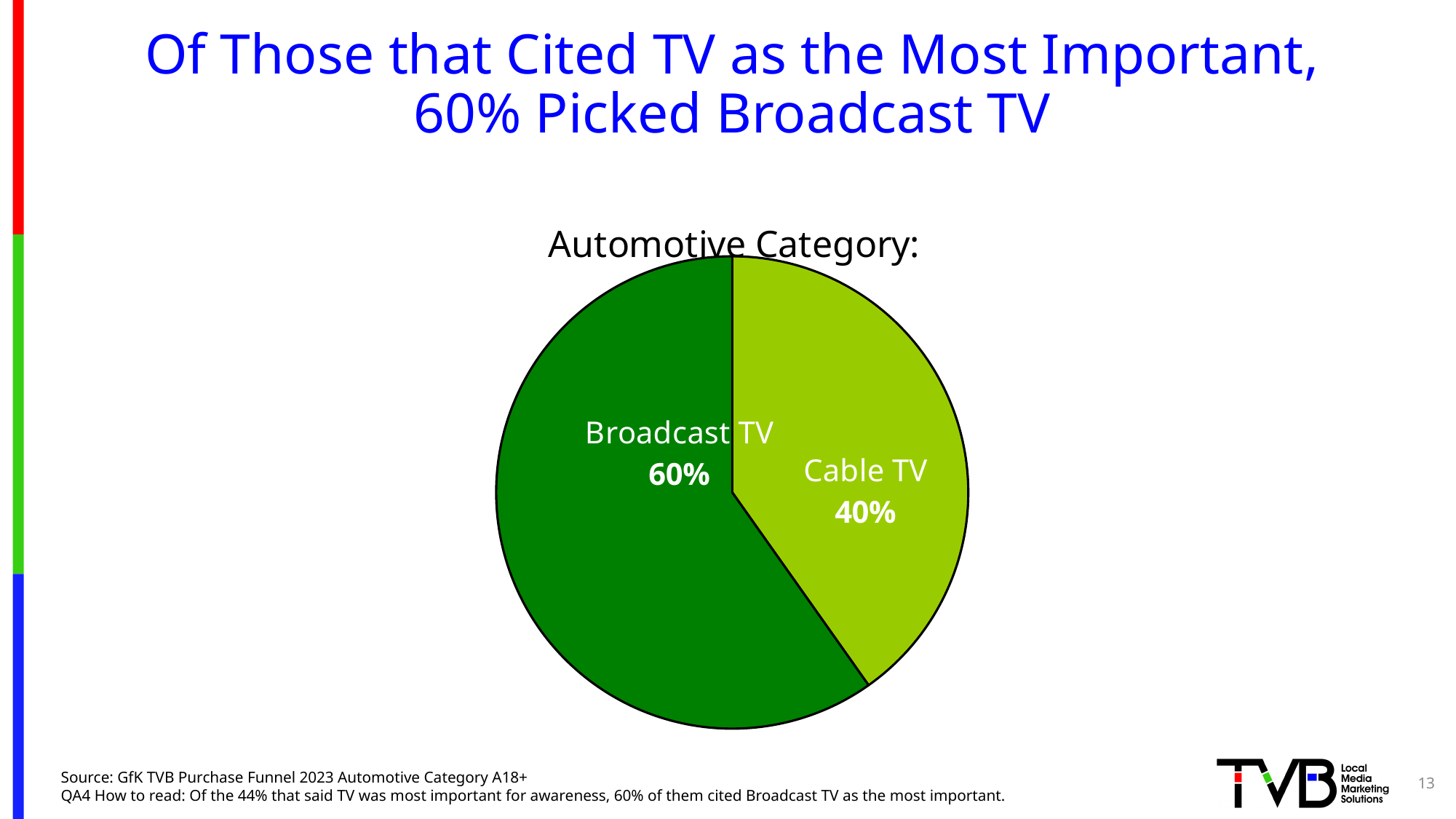
What is the title of the chart? Automotive Category: What share of the pie does Cable TV hold? 40% What share of the pie does Broadcast TV hold? 60% Which slice of the pie is the largest? Broadcast TV Which is larger, the Broadcast TV slice or the Cable TV slice? Broadcast TV What is the difference in percentage points between the Broadcast TV and Cable TV slices? 20 percentage points What colour is the Cable TV slice? Light green Which slice of the pie is the smallest? Cable TV How many slices does the pie chart have? 2 What is the combined share of the Broadcast TV and Cable TV slices? 100% What kind of chart is shown on the slide? Pie chart